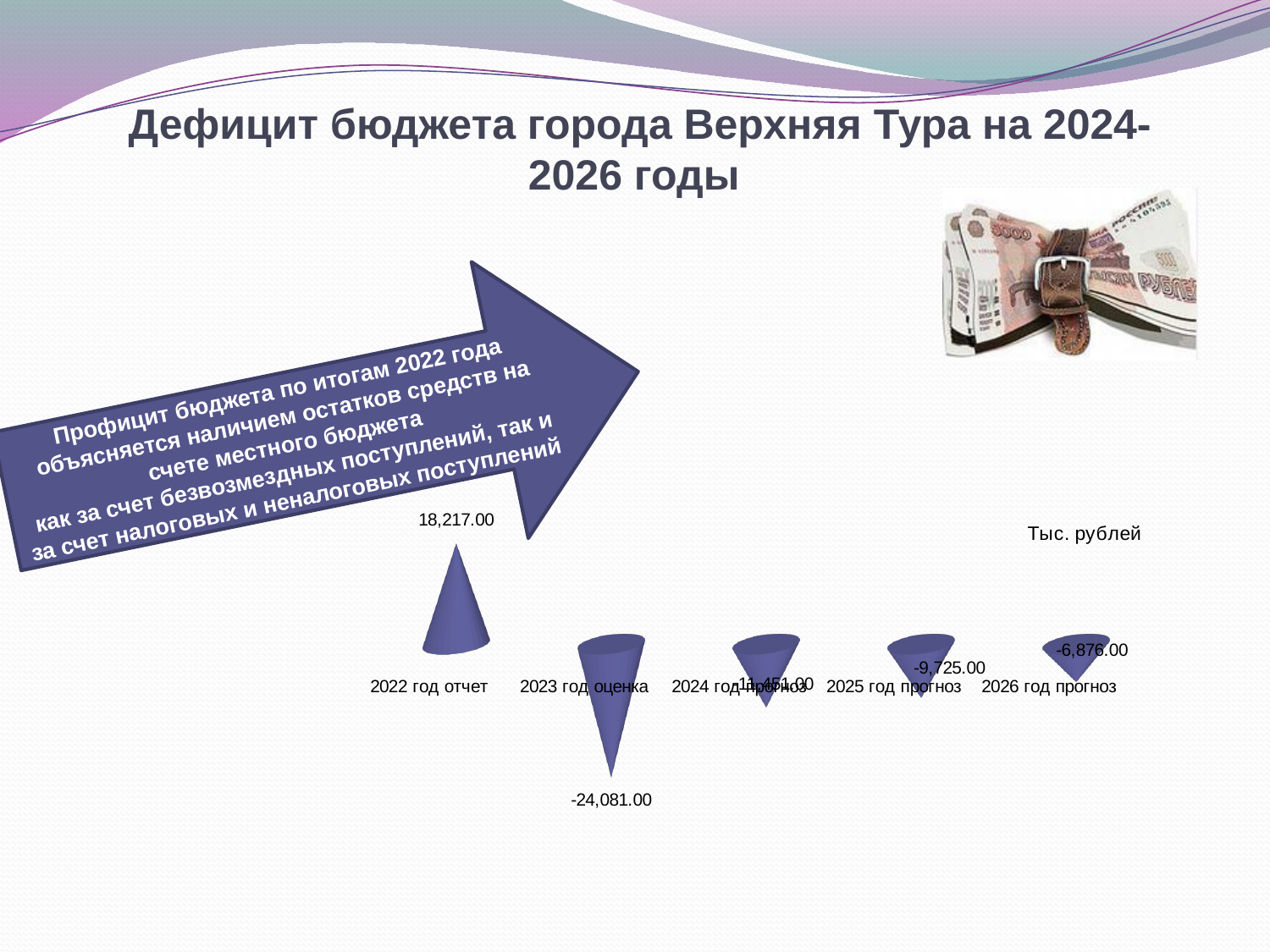
What is the value for 2022 год отчет? 18,217.00 Which category has the highest value? 2022 год отчет What is the value for 2026 год прогноз? -6,876.00 What is the value for 2023 год оценка? -24,081.00 What is the difference between the values for 2025 год прогноз and 2026 год прогноз? 2,849.00 How many categories are shown on the chart? 5 What unit is indicated next to the chart? Тыс. рублей Which category has the lowest value? 2023 год оценка What is the value for 2025 год прогноз? -9,725.00 Do the values rise or fall from 2023 год оценка to 2026 год прогноз? rise What kind of chart is shown on the slide? bar chart Which has the larger (less negative) value, 2025 год прогноз or 2026 год прогноз? 2026 год прогноз